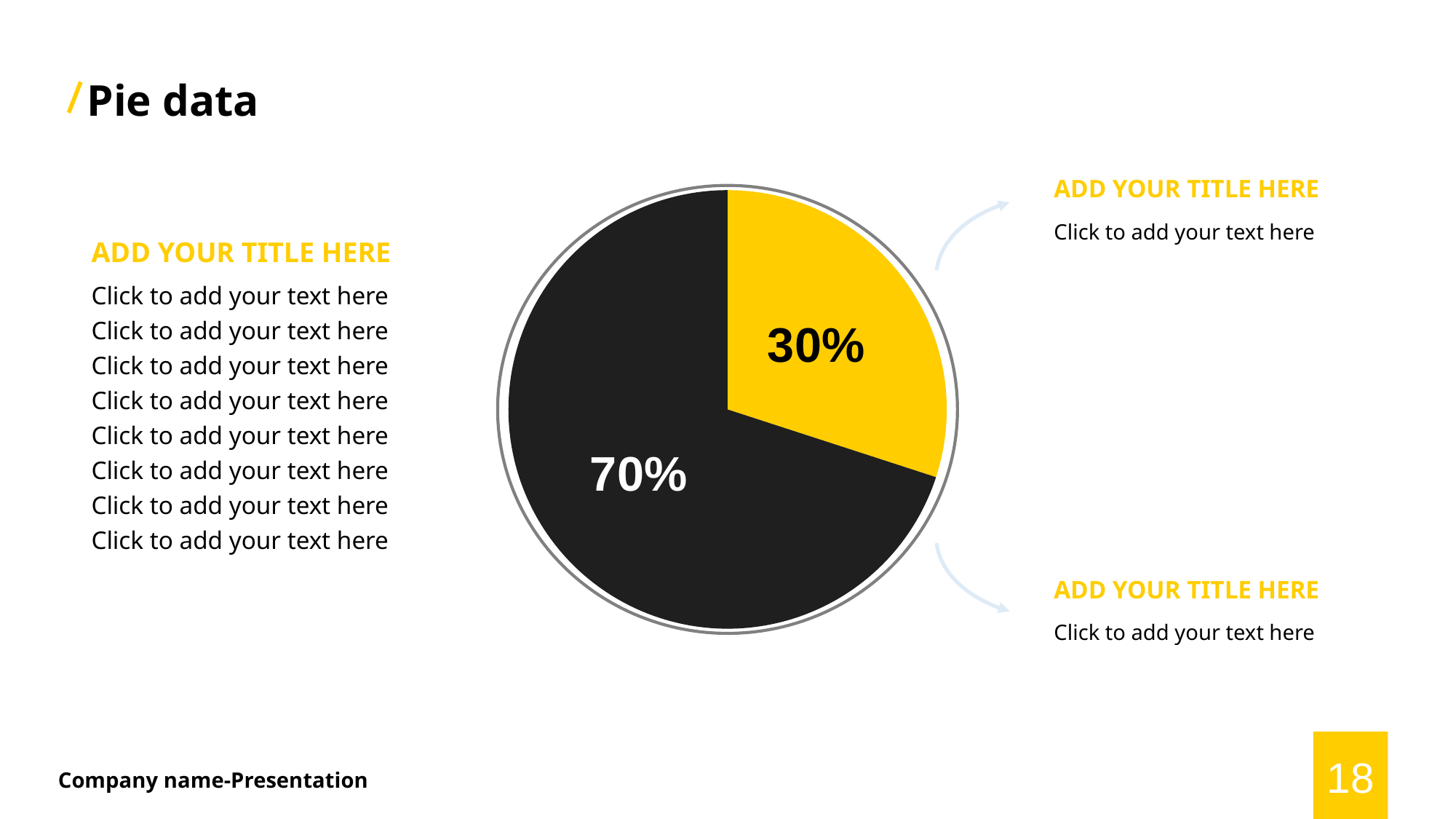
What is the difference between the black slice and the yellow slice of the pie chart? 40% What value is shown on the yellow slice of the pie chart? 30% Which slice of the pie chart is the smallest? the yellow slice (30%) What do the two slices of the pie chart add up to? 100% What is the title of the slide containing the pie chart? Pie data What colour is the slice labelled 70% in the pie chart? black What kind of chart is shown on the slide? pie chart Which slice of the pie chart is the largest? the black slice (70%) What value is shown on the black slice of the pie chart? 70% Which is larger in the pie chart, the yellow slice or the black slice? the black slice How many slices does the pie chart have? 2 What share of the pie does the yellow slice represent? 30%